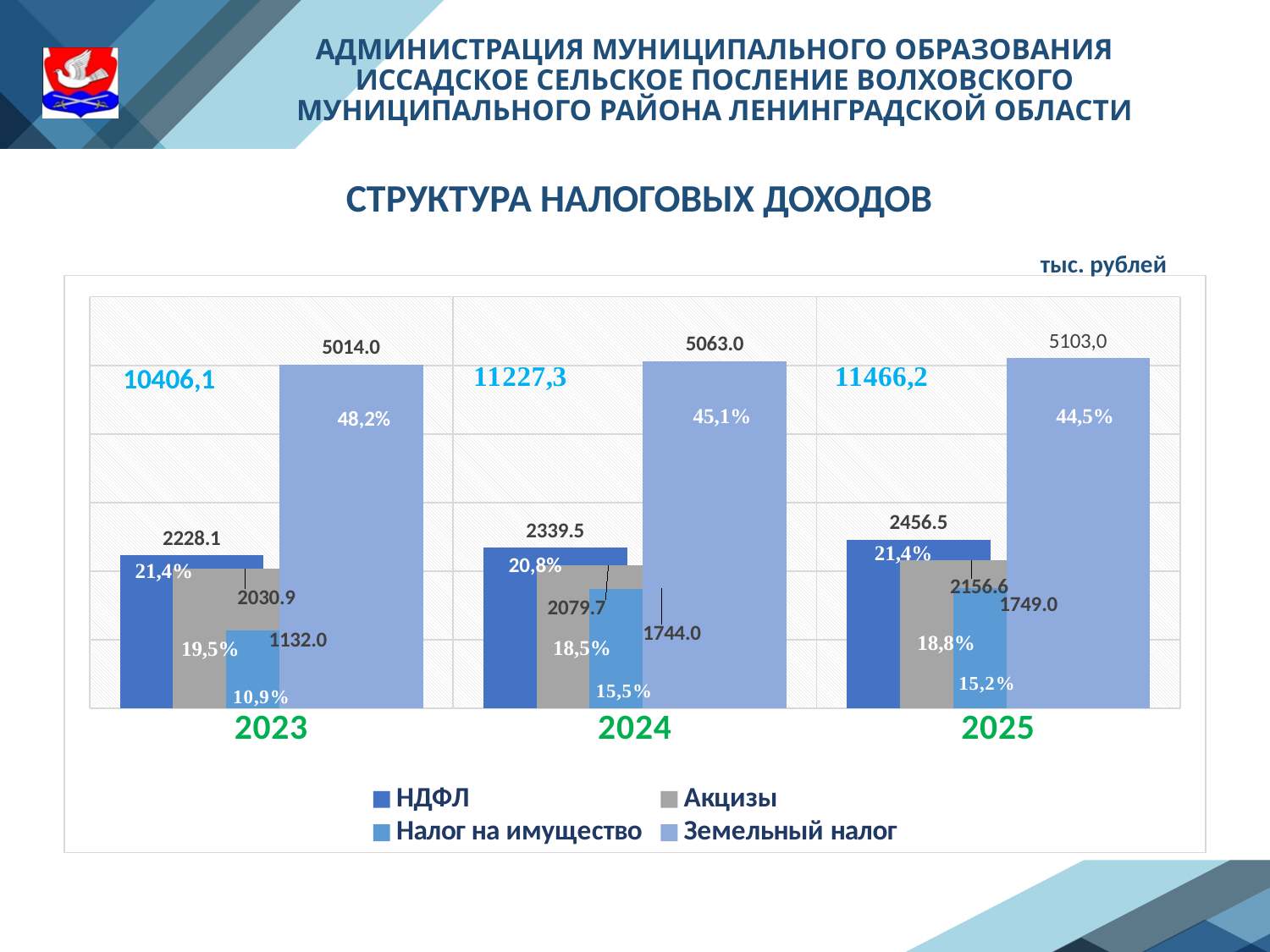
What is the value for Налог на имущество in 2025? 1749.0 Which series has the lowest value in 2023? Налог на имущество What share of tax revenue does Земельный налог make up in 2024? 45,1% Which series has the highest value in 2025? Земельный налог How many years are shown on the x axis? 3 What is the value for Акцизы in 2023? 2030.9 What is the difference between Земельный налог in 2025 and Земельный налог in 2023? 89.0 What type of chart is shown on the slide? bar chart Does the value for Налог на имущество rise or fall from 2023 to 2025? rise How many series does the legend list? 4 What is the value for НДФЛ in 2024? 2339.5 What is the value for Земельный налог in 2023? 5014.0